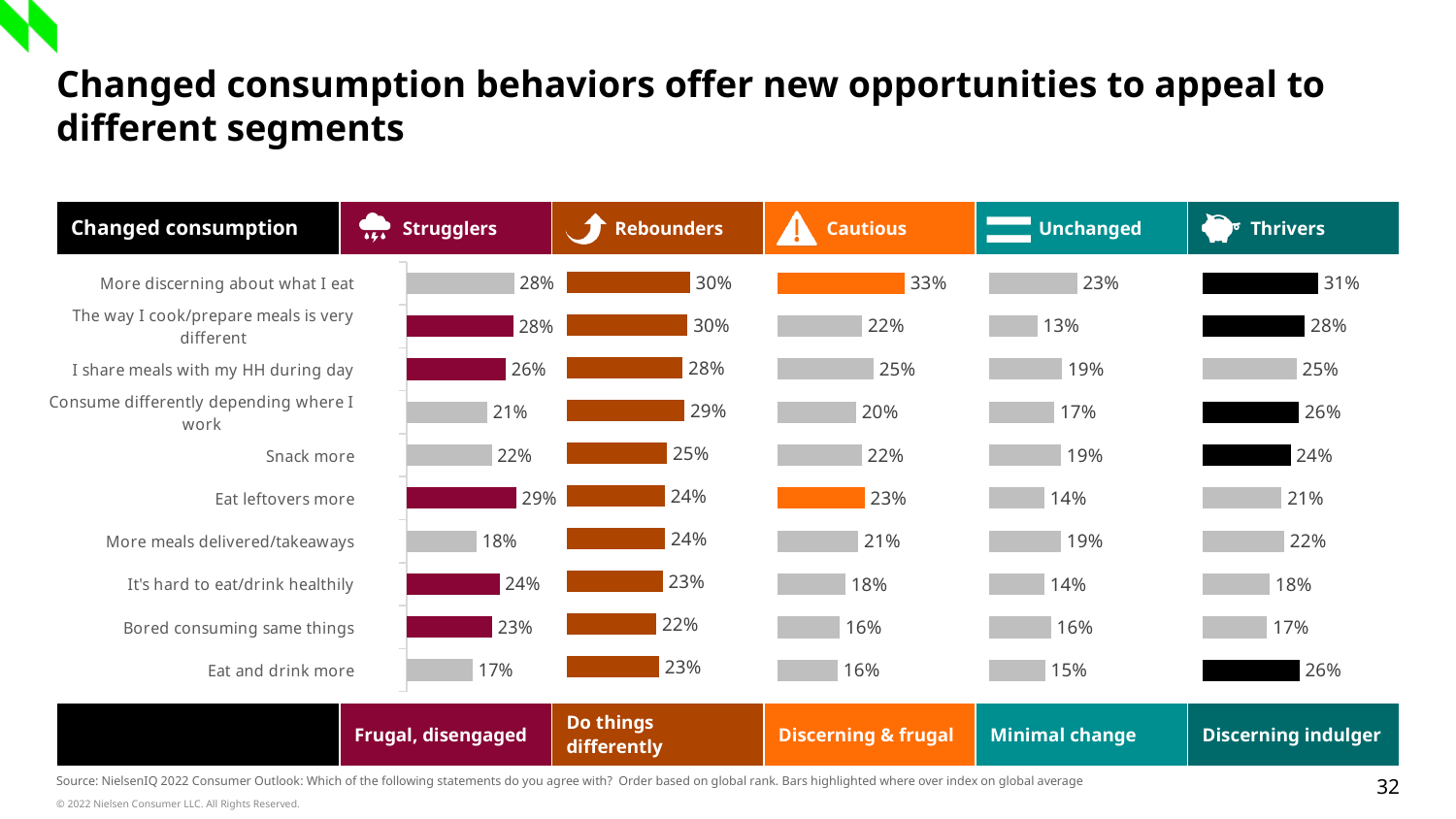
In the Rebounders chart, what is the difference between "Consume differently depending where I work" and "Bored consuming same things"? 7% In the Unchanged chart, what is the value for "The way I cook/prepare meals is very different"? 13% What descriptive label is shown beneath the Thrivers chart? Discerning indulger In the Cautious chart, which is larger: "I share meals with my HH during day" or "It's hard to eat/drink healthily"? I share meals with my HH during day In the Thrivers chart, what is the value for "Eat and drink more"? 26% In the Cautious chart, what is the value for "More discerning about what I eat"? 33% What type of chart is used for the Strugglers segment? Bar chart How many categories are plotted in the Rebounders chart? 10 In the Unchanged chart, which category has the lowest value? The way I cook/prepare meals is very different In the Strugglers chart, what is the value for "Eat leftovers more"? 29% In the Thrivers chart, which category has the lowest value? Bored consuming same things In the Strugglers chart, which category has the highest value? Eat leftovers more